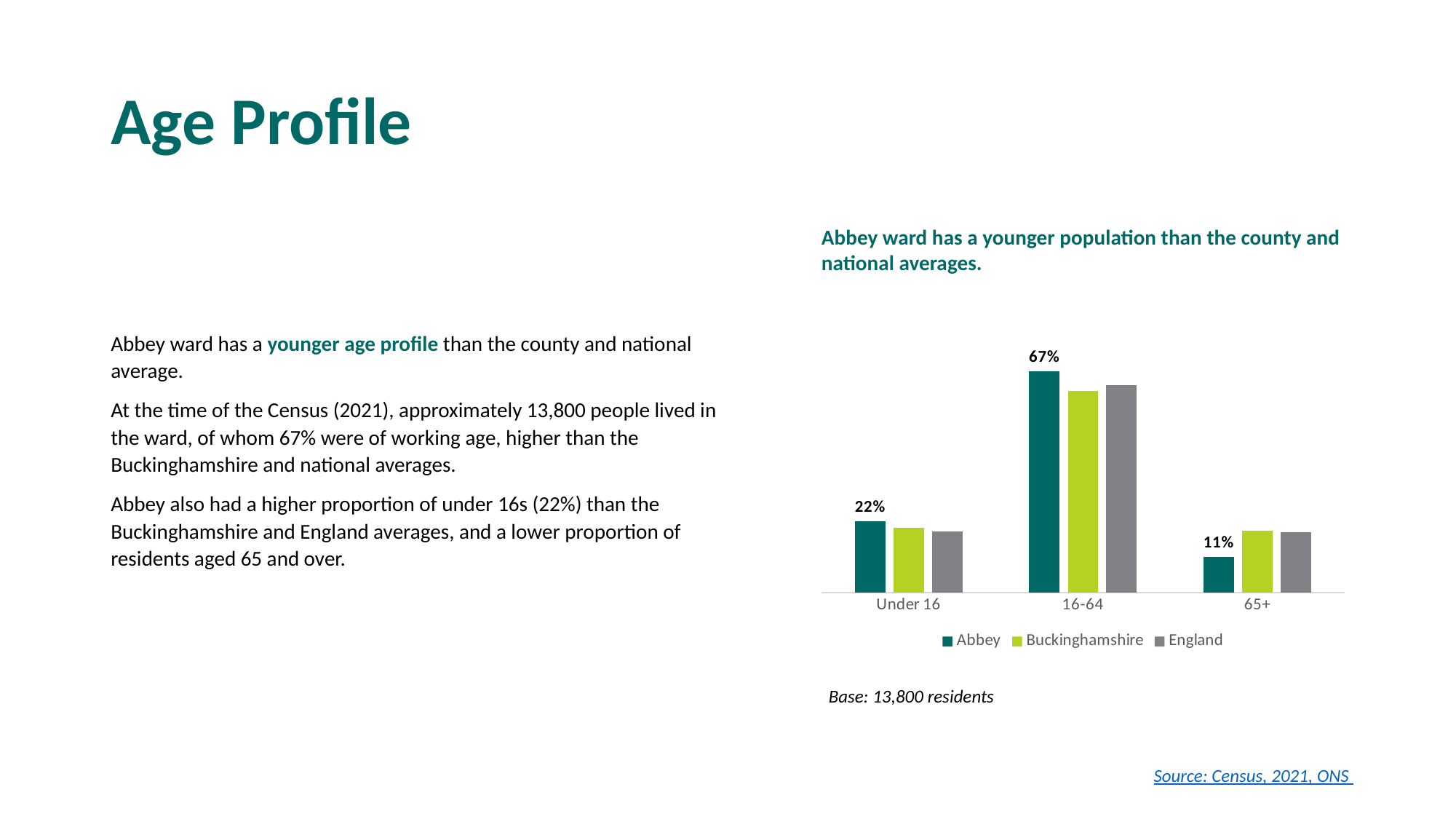
How many age groups are shown on the x axis of the chart? 3 What is the difference between Abbey's Under 16 value and its 65+ value? 11 percentage points In the 16-64 age group, which series has the larger value, Abbey or Buckinghamshire? Abbey Which age group has the highest value for Abbey? 16-64 What is the difference between Abbey's 16-64 value and its Under 16 value? 45 percentage points What percentage of Abbey ward residents are aged 65+? 11% Which age group has the lowest value for Abbey? 65+ What percentage of Abbey ward residents are under 16? 22% What type of chart is shown on the slide? Bar chart In the 65+ age group, is the value for Abbey larger or smaller than the value for England? smaller What percentage of Abbey ward residents are aged 16-64? 67% How many series does the chart legend list? 3